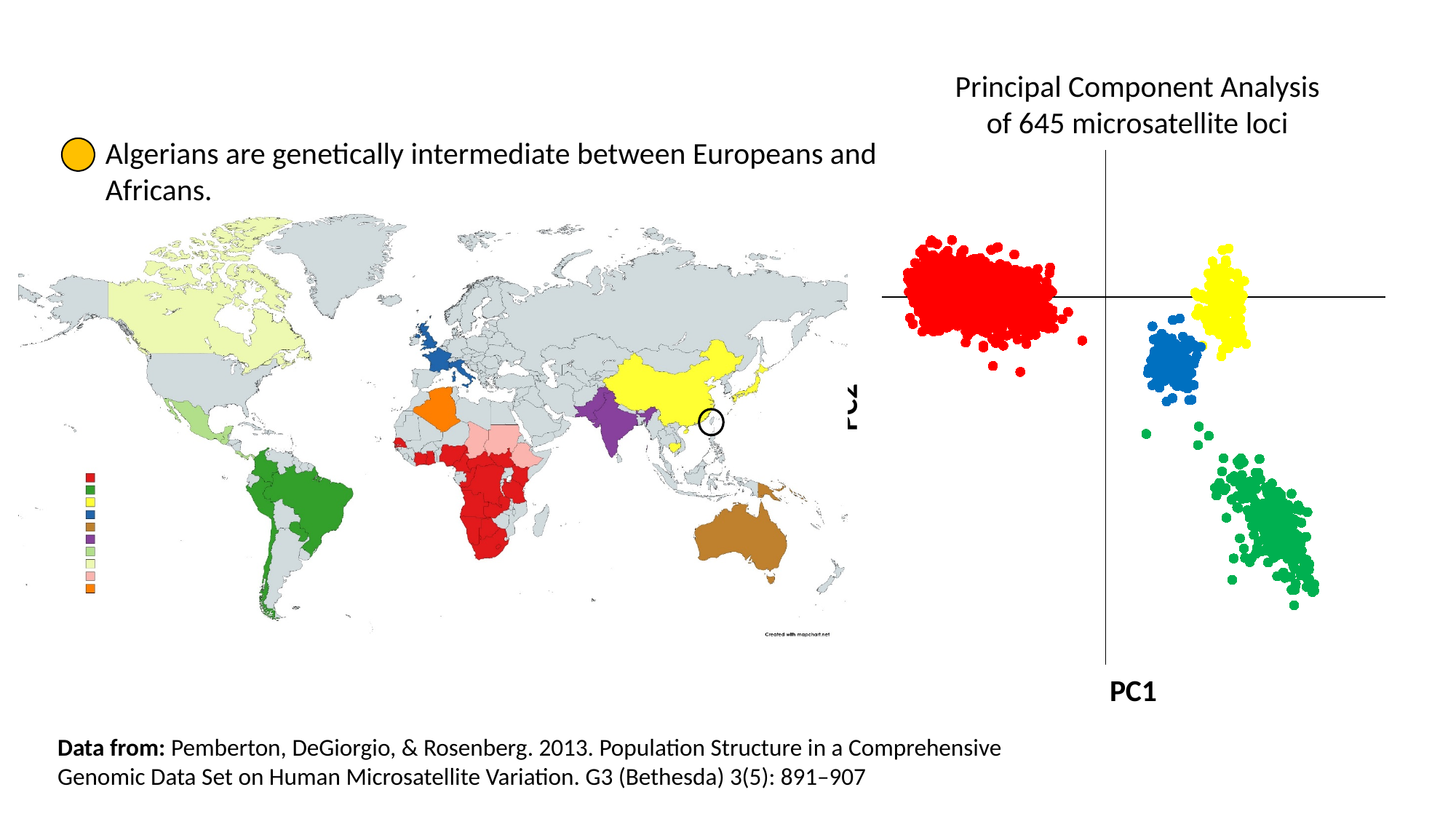
In the Principal Component Analysis chart, which coloured cluster lies lowest on the PC2 axis? green In the Principal Component Analysis chart, which coloured cluster lies furthest to the left on the PC1 axis? red What is the label of the horizontal axis of the Principal Component Analysis chart? PC1 How many distinct coloured clusters of points are shown in the Principal Component Analysis chart? 4 In the Principal Component Analysis chart, which coloured cluster lies furthest to the right on the PC1 axis? green How many microsatellite loci does the title of the Principal Component Analysis chart say were analysed? 645 In the Principal Component Analysis chart, is the red cluster on the left or the right side of the vertical PC2 axis line? left What is the title of the chart on the right of the slide? Principal Component Analysis of 645 microsatellite loci In the Principal Component Analysis chart, which cluster is positioned higher on the PC2 axis, the blue cluster or the green cluster? blue What kind of chart is the Principal Component Analysis plot on the right of the slide? scatter chart In the Principal Component Analysis chart, which cluster is further to the left on the PC1 axis, the red cluster or the yellow cluster? red